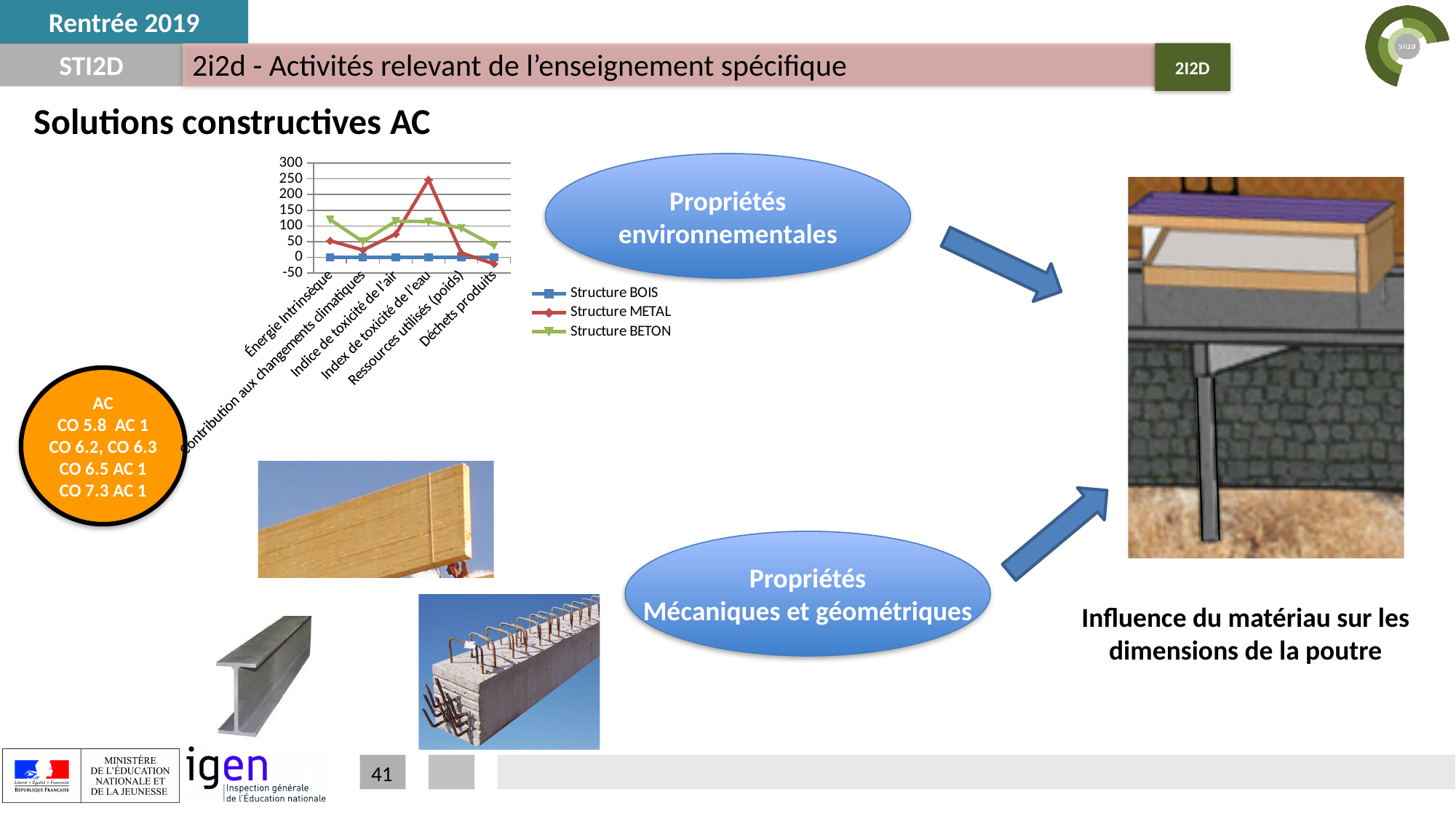
Does the Structure BETON series rise or fall from Ressources utilisés (poids) to Déchets produits? fall What colour is the Structure METAL line in the chart? red For Index de toxicité de l'eau, which series has the larger value, Structure METAL or Structure BETON? Structure METAL How many series does the chart's legend list? 3 What kind of chart is shown on the slide? line chart Which series has the lowest value for Index de toxicité de l'eau? Structure BOIS Is the Structure METAL value for Contribution aux changements climatiques greater or less than 50? less Is the Structure BETON value for Énergie Intrinsèque greater or less than 100? greater Is the Structure METAL value for Index de toxicité de l'eau greater or less than 200? greater How many categories are plotted along the x axis of the chart? 6 For Énergie Intrinsèque, which series has the larger value, Structure BETON or Structure METAL? Structure BETON For the Structure METAL series, which category has the highest value? Index de toxicité de l'eau